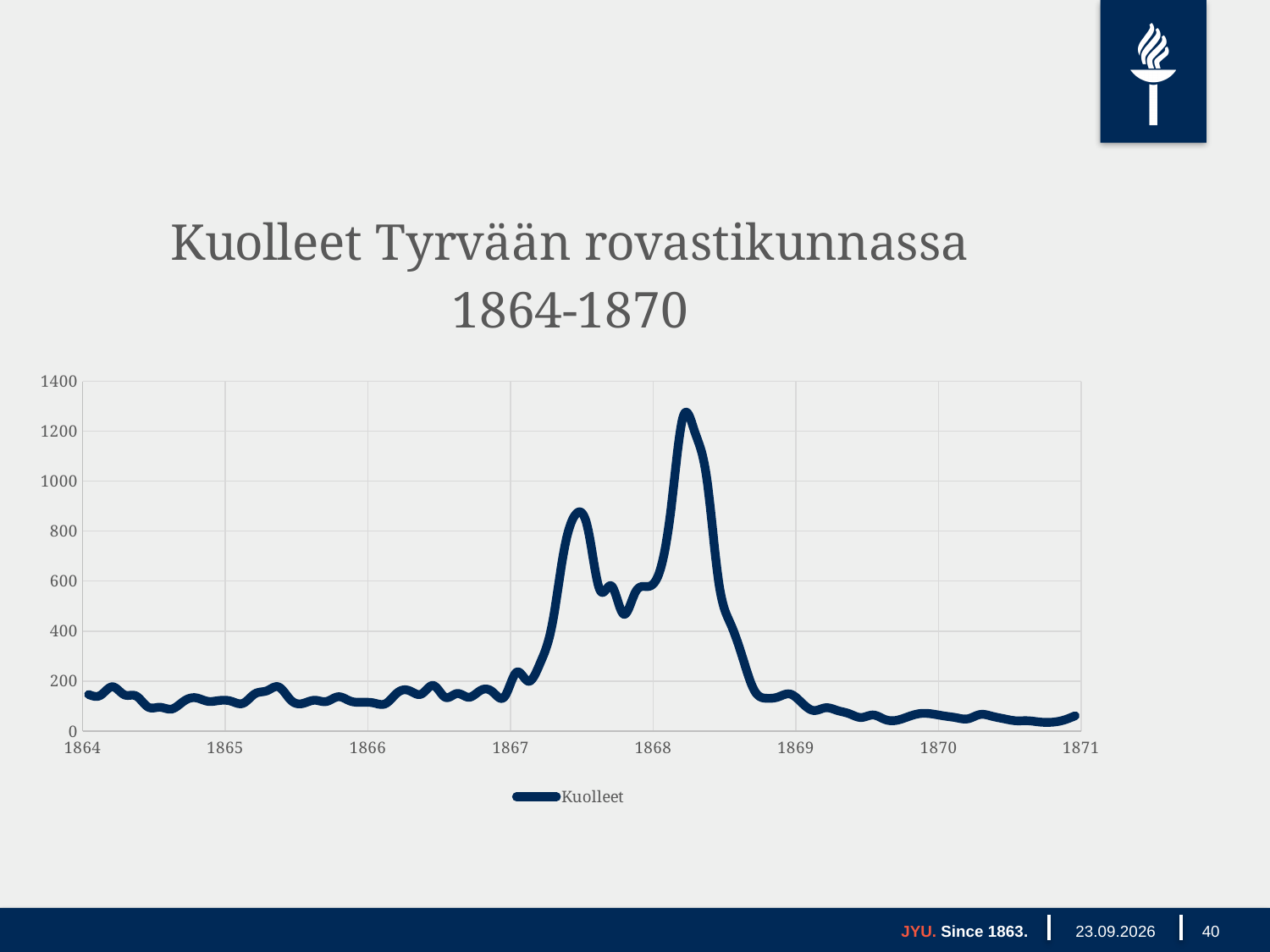
Is the highest peak of the line greater or less than 1200? greater How many series does the legend list? 1 Is the value at the start of 1869 greater or less than 200? less How many year labels are shown on the x axis? 8 Is the value at the start of 1864 greater or less than 200? less What kind of chart is shown on the slide? line chart In which year does the line reach its highest peak? 1868 Which is higher: the peak in 1867 or the peak in 1868? the peak in 1868 What is the title of the chart? Kuolleet Tyrvään rovastikunnassa 1864-1870 What is the name of the series shown in the legend? Kuolleet Do the values generally rise or fall from 1869 to 1871? fall